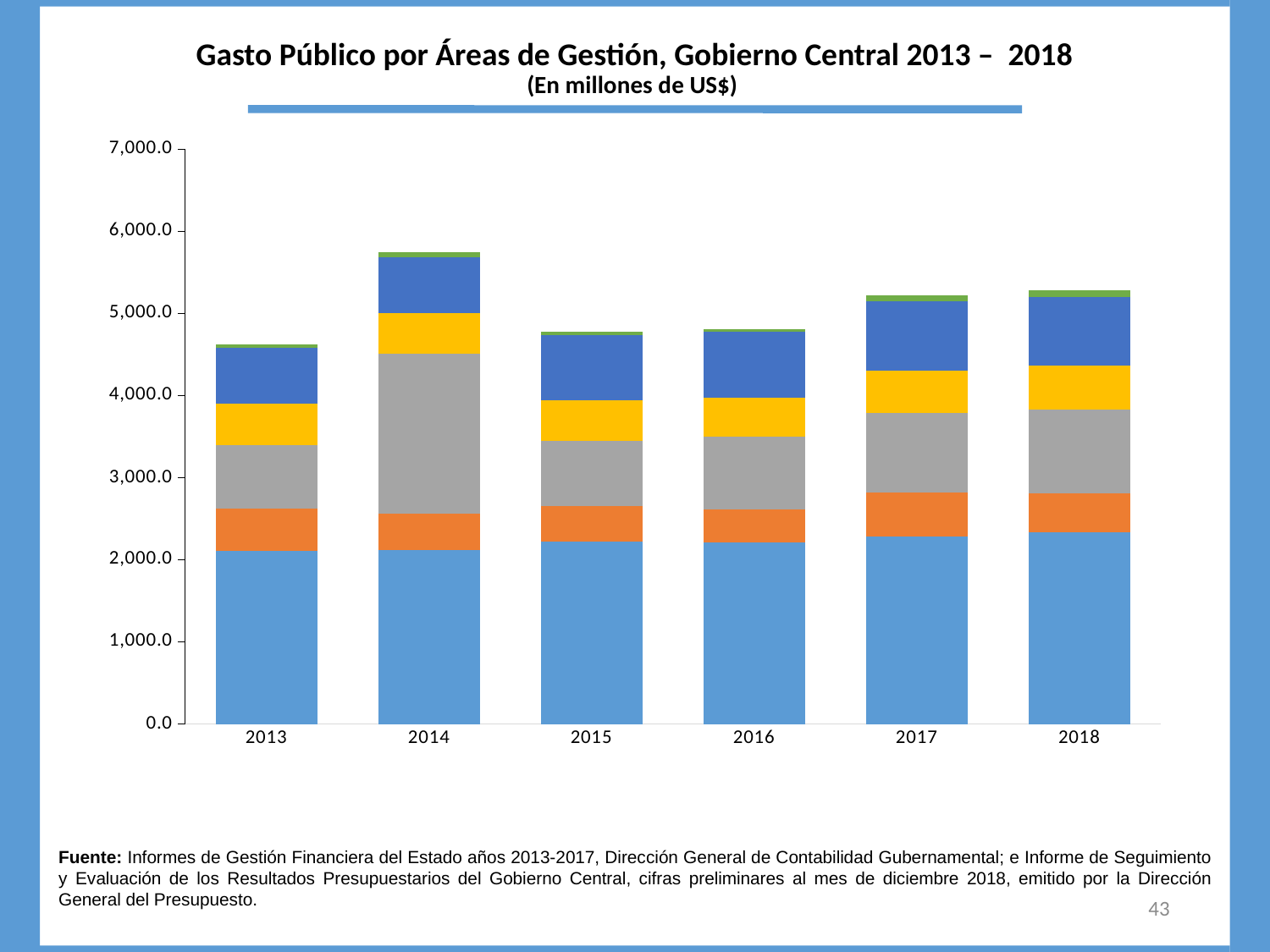
Which year has the larger total bar, 2013 or 2018? 2018 How many years are shown on the x axis? 6 In what units are the values expressed, according to the chart subtitle? En millones de US$ Which year has the highest total bar? 2014 What is the title of the chart? Gasto Público por Áreas de Gestión, Gobierno Central 2013 – 2018 Which year has the lowest total bar? 2013 Is the total bar for 2016 greater or less than 5,000.0? less Is the total bar for 2013 greater or less than 5,000.0? less What kind of chart is shown on the slide? Stacked bar chart Which year has the larger total bar, 2014 or 2017? 2014 Is the total bar for 2014 greater or less than 5,000.0? greater